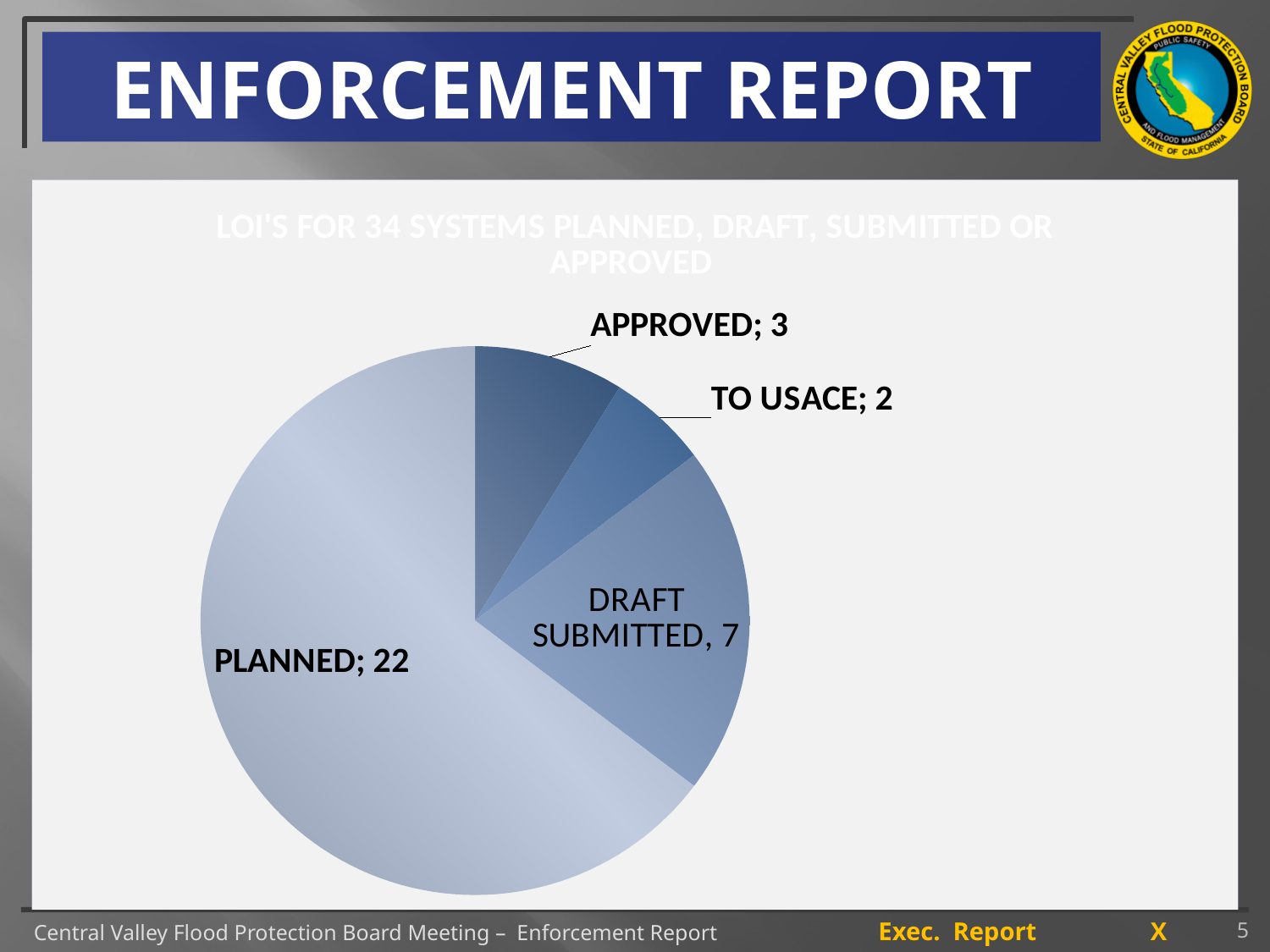
What is the value for PLANNED? 22 What is the title of the pie chart? LOI'S FOR 34 SYSTEMS PLANNED, DRAFT, SUBMITTED OR APPROVED Which category has the largest slice? PLANNED What is the total of all slices in the pie chart? 34 Which is larger, APPROVED or TO USACE? APPROVED What is the value for TO USACE? 2 What is the value for DRAFT SUBMITTED? 7 How many slices does the pie chart have? 4 Which category has the smallest slice? TO USACE What is the value for APPROVED? 3 What kind of chart is shown on the slide? pie chart What is the difference between the PLANNED and DRAFT SUBMITTED values? 15